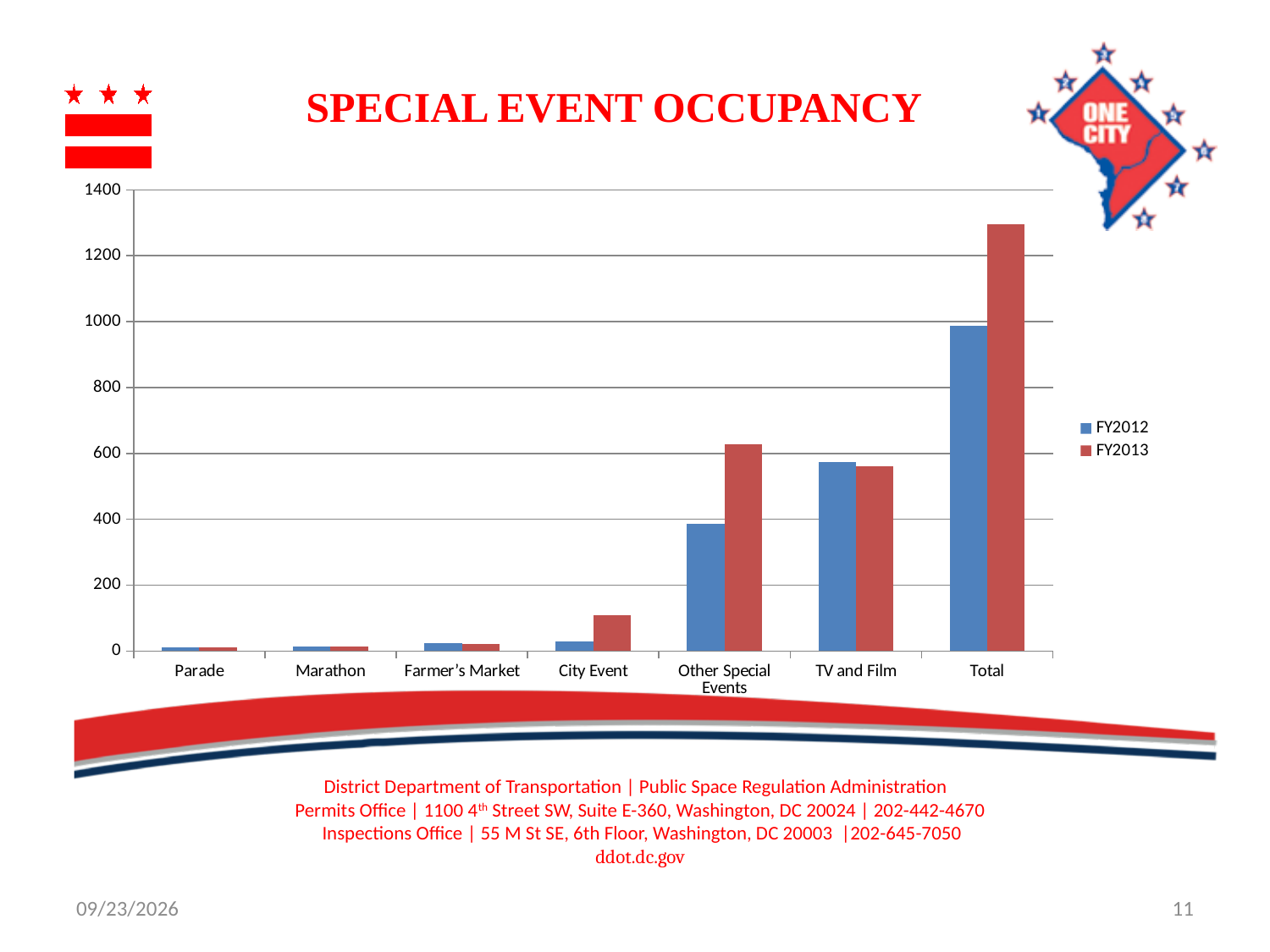
Is the FY2013 value for City Event greater or less than 200? less For City Event, which series has the larger value, FY2012 or FY2013? FY2013 Which colour represents FY2012 in the legend? blue For Other Special Events, which series has the larger value, FY2012 or FY2013? FY2013 What is the title of the chart? SPECIAL EVENT OCCUPANCY How many series does the legend list? 2 Is the FY2013 value for Other Special Events greater or less than 600? greater Is the FY2013 value for Total greater or less than 1200? greater Which category has the highest FY2013 value? Total How many categories are shown on the x axis? 7 What kind of chart is shown on the slide? bar chart